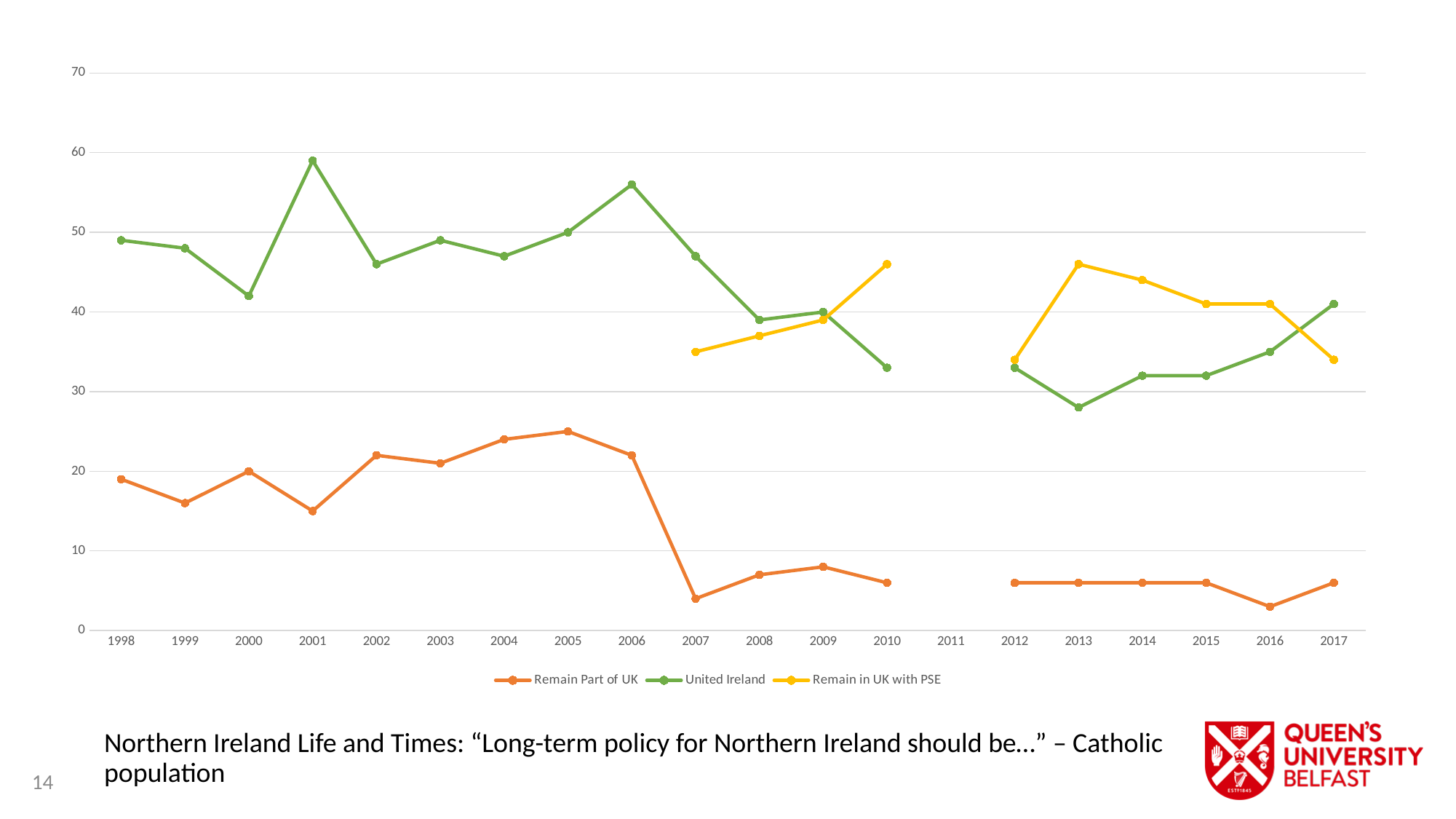
Is the value for United Ireland in 2001 greater or less than 50? greater How many years are labelled on the x axis? 20 Does the Remain Part of UK series rise or fall between 2005 and 2007? fall Which series is drawn in yellow? Remain in UK with PSE In 2013, which is larger: Remain in UK with PSE or United Ireland? Remain in UK with PSE Is the value for Remain in UK with PSE in 2010 greater or less than 40? greater Which year on the x axis has no data points plotted for any series? 2011 Is the value for Remain Part of UK in 2007 greater or less than 10? less In which year does the United Ireland series reach its highest value? 2001 How many series does the legend list? 3 What kind of chart is shown on the slide? line chart In 2017, which is larger: United Ireland or Remain in UK with PSE? United Ireland